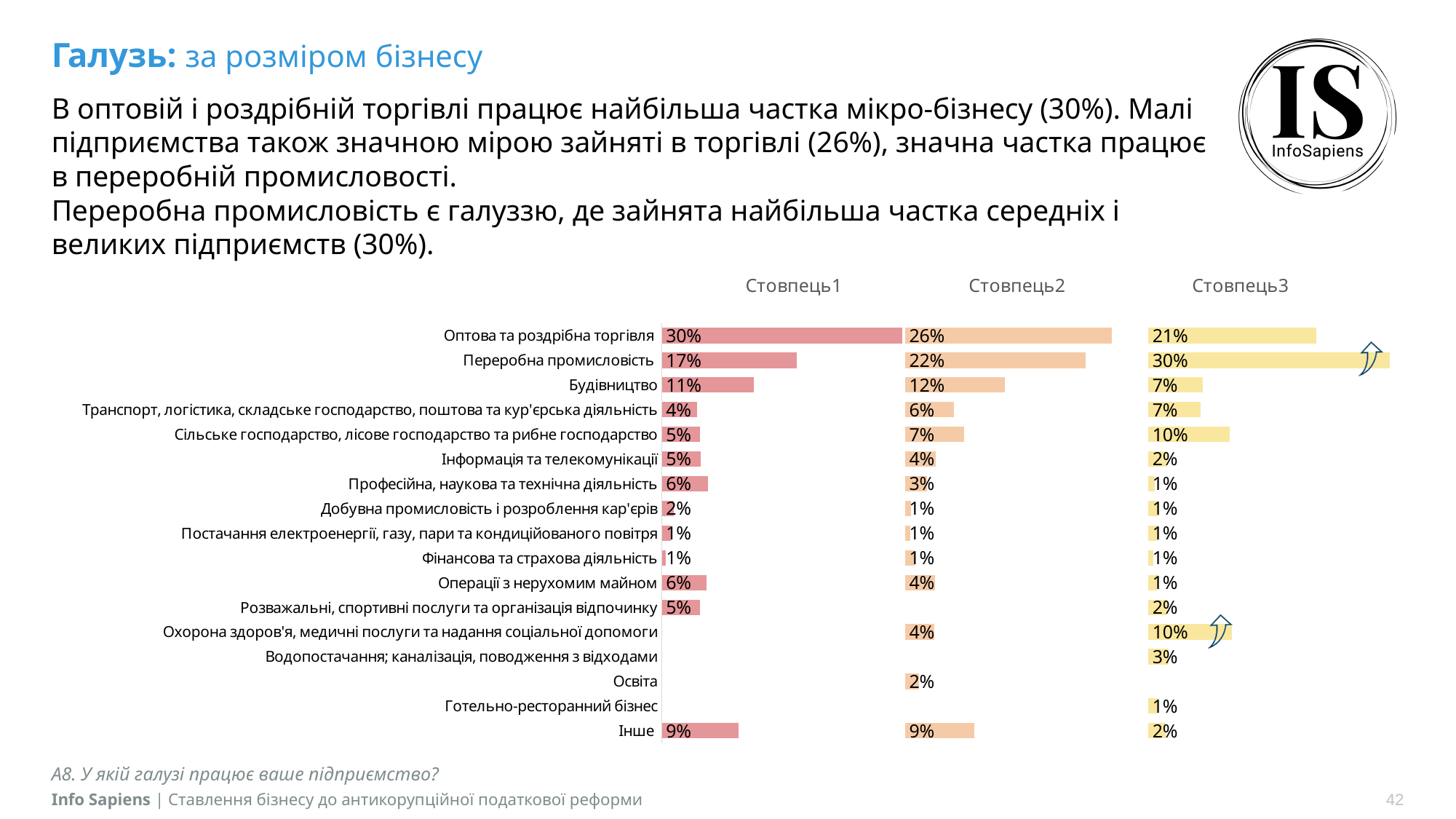
What is the difference between Стовпець3 and Стовпець1 for Переробна промисловість? 13% What is the value for Охорона здоров'я, медичні послуги та надання соціальної допомоги in Стовпець3? 10% What is the value for Переробна промисловість in Стовпець3? 30% What type of chart is shown on the slide? Bar chart What is the value for Оптова та роздрібна торгівля in Стовпець1? 30% What is the difference between Стовпець1 and Стовпець3 for Оптова та роздрібна торгівля? 9% Which category has the highest value in Стовпець3? Переробна промисловість How many industry categories are listed in the chart? 17 Which is larger for Сільське господарство, лісове господарство та рибне господарство: Стовпець1 or Стовпець3? Стовпець3 What is the value for Будівництво in Стовпець2? 12% How many series (columns) does the chart show? 3 Which category has the highest value in Стовпець2? Оптова та роздрібна торгівля